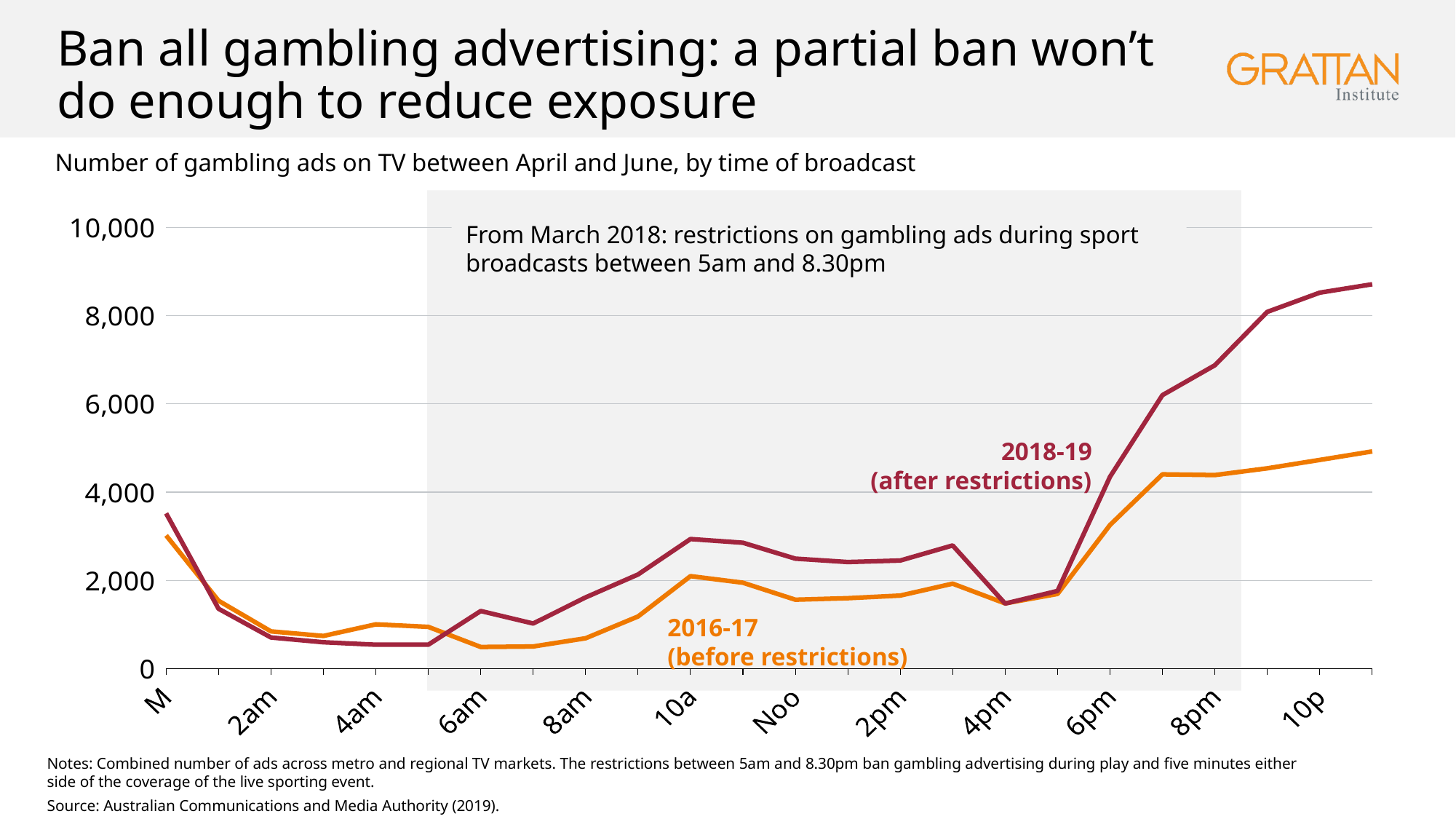
What period does the shaded region on the chart say restrictions on gambling ads during sport broadcasts apply to? Between 5am and 8.30pm What kind of chart is shown on the slide? Line chart Is the value for 2018-19 at 4pm greater or less than 2,000? less Between midnight and 2am, does the 2016-17 line rise or fall? Fall Is the value for 2016-17 at 10pm greater or less than 6,000? less At 8pm, which series has the higher number of gambling ads, 2016-17 or 2018-19? 2018-19 Between 4pm and 8pm, does the 2018-19 line rise or fall? Rise Which series is labelled as 'after restrictions'? 2018-19 Is the value for 2018-19 at 8pm greater or less than 6,000? greater How many data series are plotted on the chart? 2 At 4am, which series has the higher number of gambling ads, 2016-17 or 2018-19? 2016-17 At 10am, which series has the higher number of gambling ads, 2016-17 or 2018-19? 2018-19